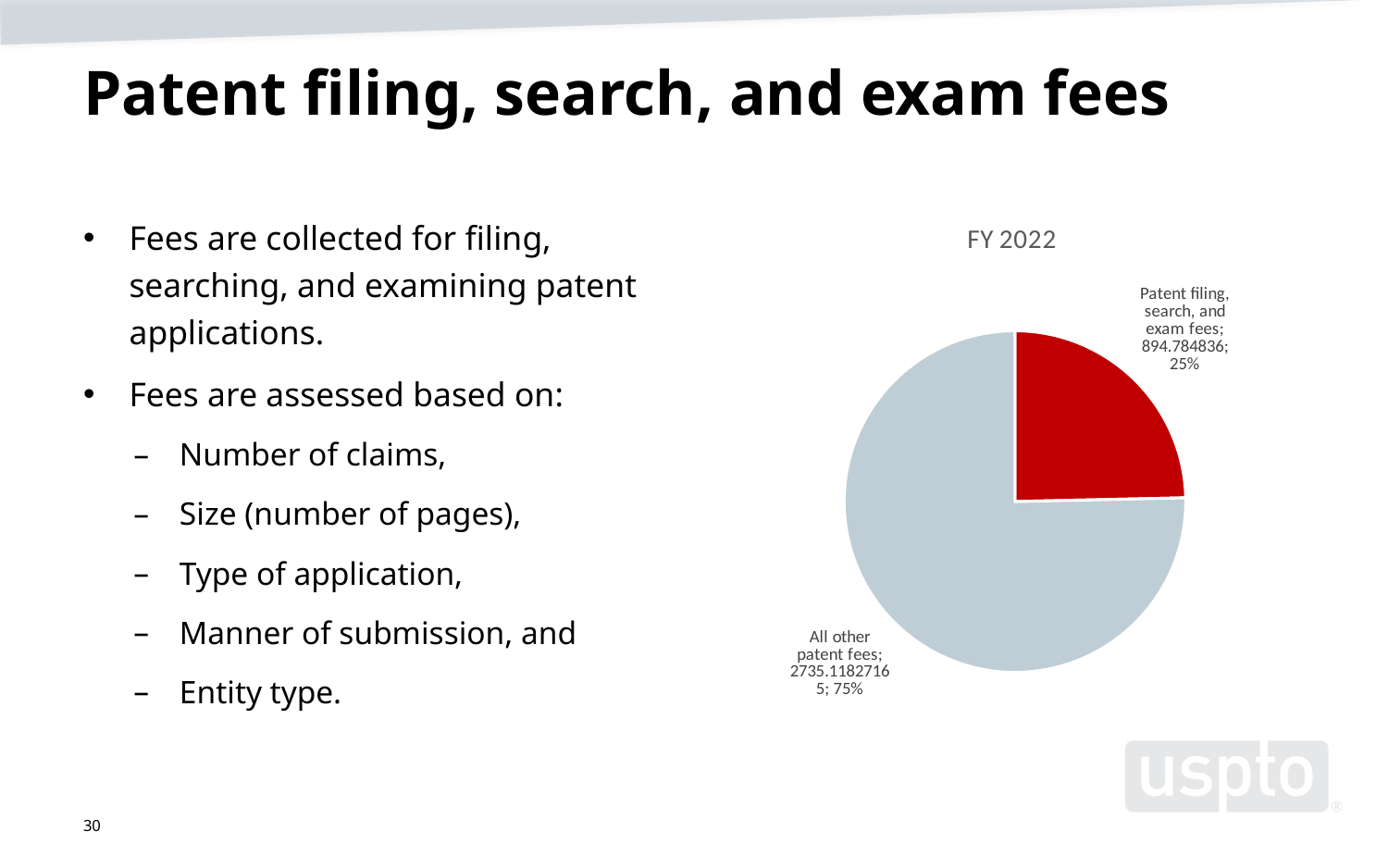
Which slice is the smallest in the pie chart? Patent filing, search, and exam fees What type of chart is shown on the slide? Pie chart Which is larger: 'All other patent fees' or 'Patent filing, search, and exam fees'? All other patent fees What colour is the 'Patent filing, search, and exam fees' slice? Red By how many percentage points does the share of 'All other patent fees' exceed that of 'Patent filing, search, and exam fees'? 50 percentage points What is the value shown for 'Patent filing, search, and exam fees'? 894.784836 What share of the pie is 'Patent filing, search, and exam fees'? 25% How many slices does the pie chart have? 2 Which slice is the largest in the pie chart? All other patent fees What is the value shown for 'All other patent fees'? 2735.11827165 What share of the pie is 'All other patent fees'? 75% What is the title of the chart? FY 2022